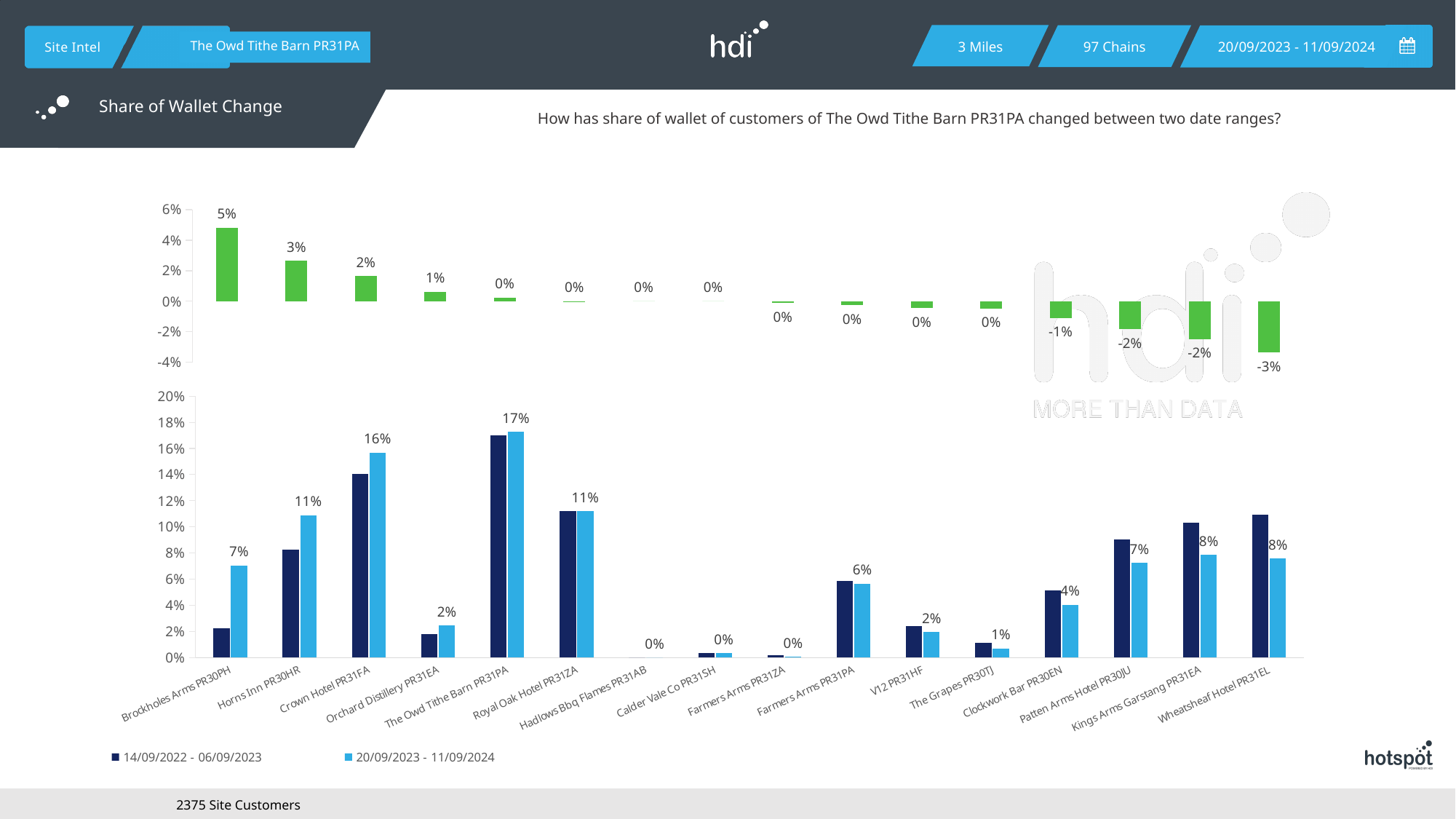
In the top chart (share of wallet change), which category has the lowest value? Wheatsheaf Hotel PR31EL In the bottom chart, what is the value for The Owd Tithe Barn PR31PA in the 20/09/2023 - 11/09/2024 series? 17% In the bottom chart, what is the difference between the 20/09/2023 - 11/09/2024 values for The Owd Tithe Barn PR31PA and Horns Inn PR30HR? 6% In the top chart (share of wallet change), what is the value for Brockholes Arms PR30PH? 5% In the bottom chart, which is larger in the 20/09/2023 - 11/09/2024 series: Brockholes Arms PR30PH or Farmers Arms PR31PA? Brockholes Arms PR30PH In the bottom chart, is the 14/09/2022 - 06/09/2023 value for Crown Hotel PR31FA greater or less than 12%? greater In the top chart (share of wallet change), which category has the highest value? Brockholes Arms PR30PH How many series does the legend of the bottom chart list? 2 How many categories are shown on the x axis of the bottom chart? 16 In the top chart (share of wallet change), what is the value for Wheatsheaf Hotel PR31EL? -3% In the bottom chart, is the 14/09/2022 - 06/09/2023 value for Brockholes Arms PR30PH greater or less than 4%? less In the bottom chart, what is the value for Crown Hotel PR31FA in the 20/09/2023 - 11/09/2024 series? 16%